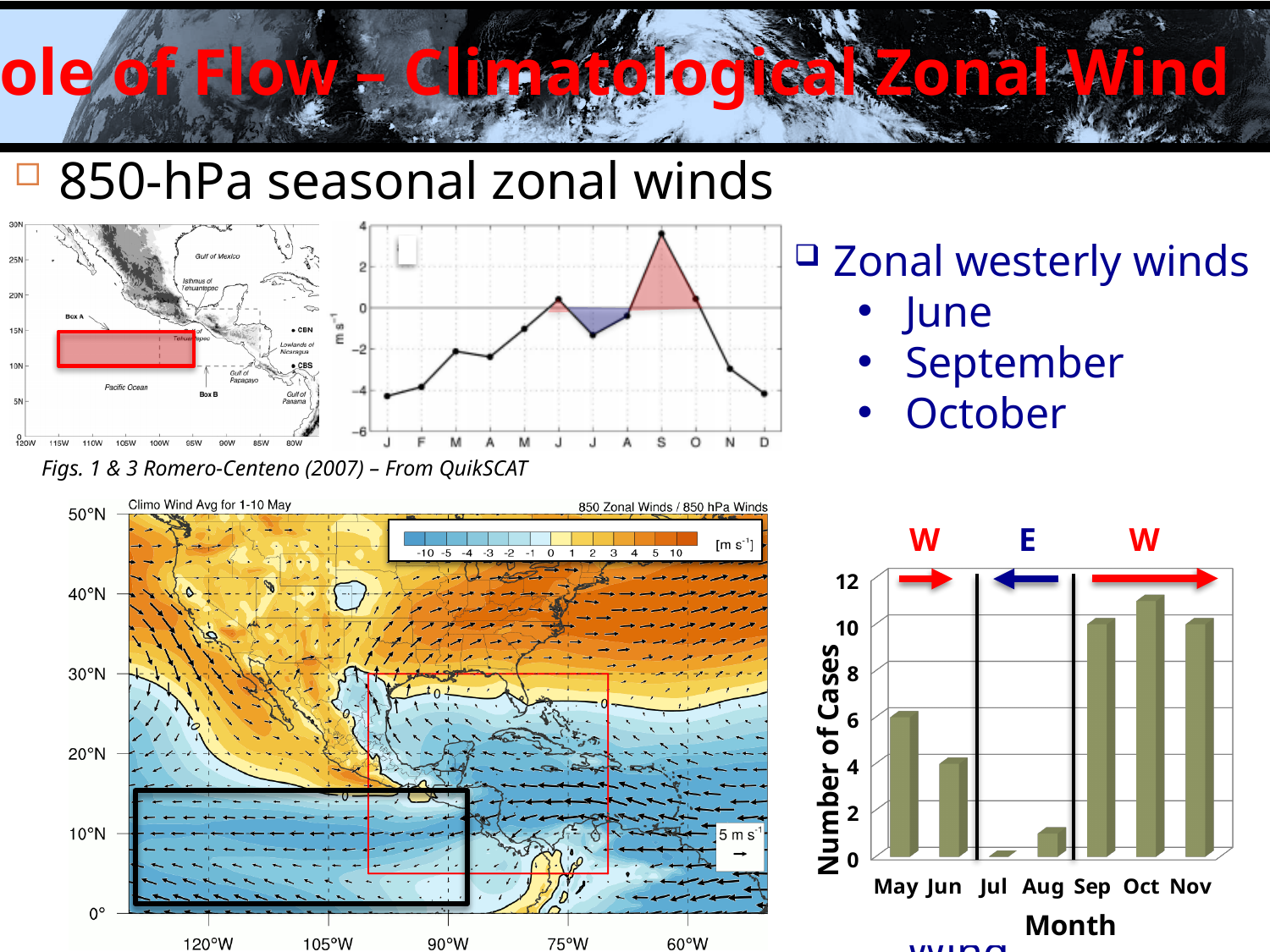
In the bar chart of Number of Cases by Month, what is the number of cases for May? 6 In the bar chart of Number of Cases by Month, which month has the highest number of cases? Oct In the bar chart of Number of Cases by Month, is the value for Aug greater or less than 2? less In the line chart of monthly zonal wind (m s-1) at the top of the slide, which month has the highest value? S In the bar chart of Number of Cases by Month, which has more cases, May or Jun? May In the line chart of monthly zonal wind (m s-1) at the top of the slide, is the value for S greater or less than 2? greater In the bar chart of Number of Cases by Month, what is the label of the y axis? Number of Cases In the bar chart of Number of Cases by Month, what is the number of cases for Sep? 10 In the bar chart of Number of Cases by Month, what is the number of cases for Jun? 4 In the bar chart titled 'Number of Cases' by Month, what type of chart is it? bar chart In the bar chart of Number of Cases by Month, which month has the lowest number of cases? Jul In the bar chart of Number of Cases by Month, how many months are shown on the x axis? 7